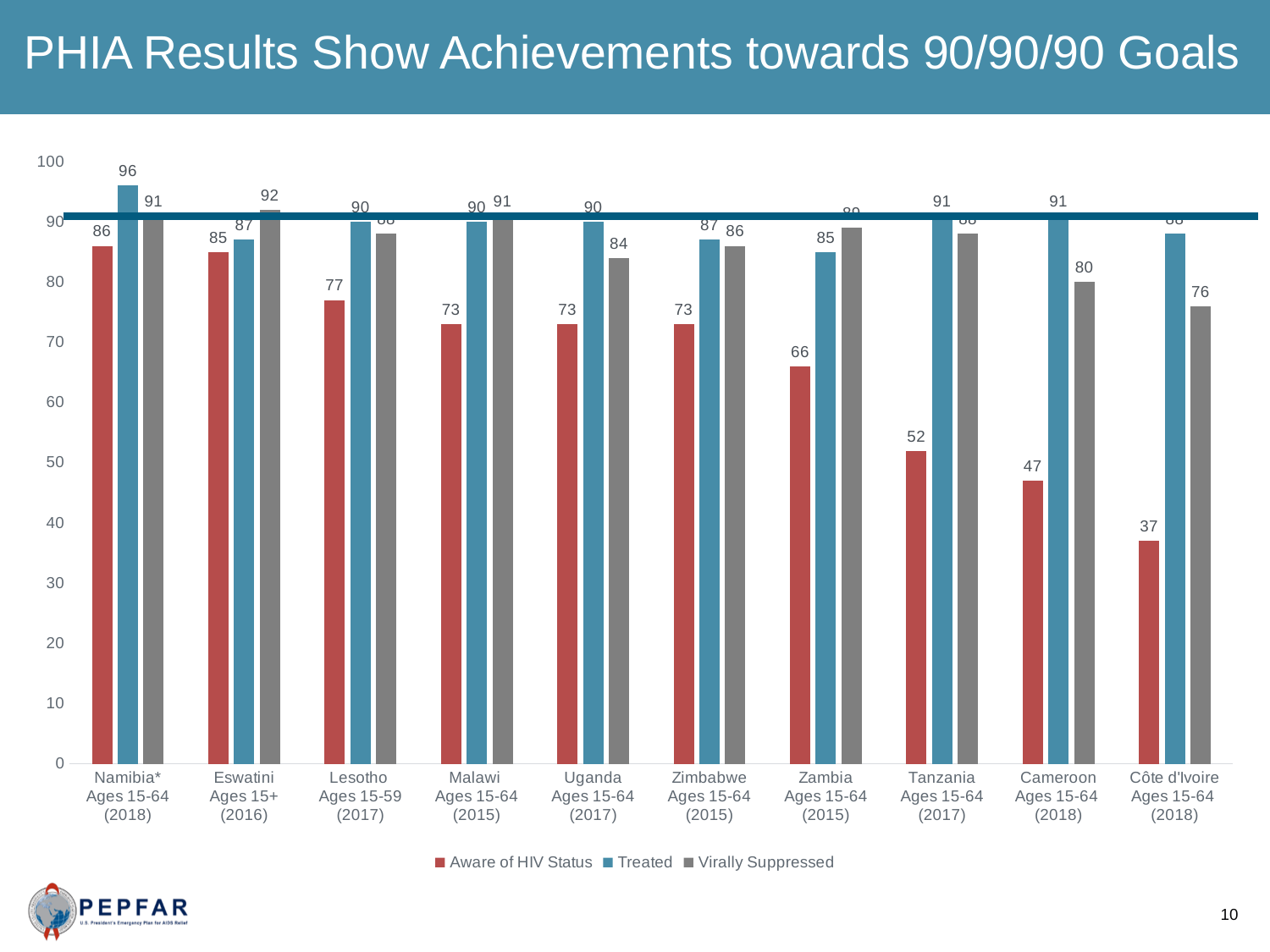
Do the Aware of HIV Status values rise or fall from left to right across the countries? fall Is the Virally Suppressed value for Lesotho Ages 15-59 (2017) greater or less than 80? greater What kind of chart is shown on the slide? bar chart Which country has the lowest Aware of HIV Status value? Côte d'Ivoire What is the Treated value for Namibia* Ages 15-64 (2018)? 96 What is the Virally Suppressed value for Eswatini Ages 15+ (2016)? 92 What is the difference between the Treated value and the Aware of HIV Status value for Cameroon Ages 15-64 (2018)? 44 How many series does the legend list? 3 What is the Aware of HIV Status value for Namibia* Ages 15-64 (2018)? 86 Which is larger: the Aware of HIV Status value for Lesotho or for Malawi? Lesotho Which country has the highest Treated value? Namibia* How many countries are shown on the x axis? 10